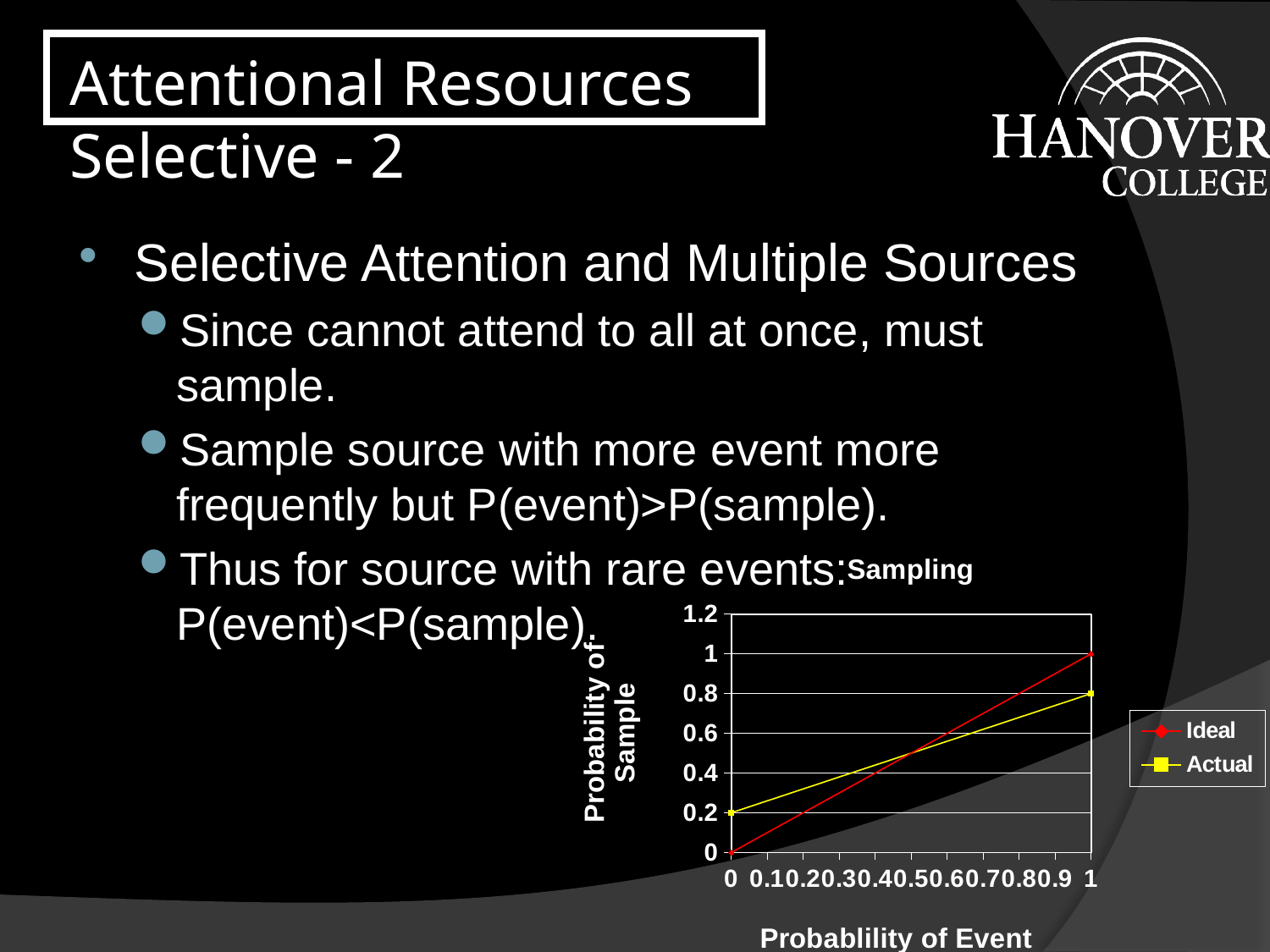
In the "Sampling" chart, what is the difference between the Ideal and Actual Probability of Sample when the Probability of Event is 1? 0.2 What is the title of the chart on the slide? Sampling In the "Sampling" chart, what is the Probability of Sample for the Ideal series when the Probability of Event is 1? 1 In the "Sampling" chart, what is the Probability of Sample for the Ideal series when the Probability of Event is 0? 0 In the "Sampling" chart, what is the Probability of Sample for the Actual series when the Probability of Event is 0? 0.2 In the "Sampling" chart, which series has the higher Probability of Sample when the Probability of Event is 1? Ideal In the "Sampling" chart, what is the Probability of Sample for the Actual series when the Probability of Event is 1? 0.8 What kind of chart is the "Sampling" chart? line chart What are the two series named in the legend of the "Sampling" chart? Ideal and Actual In the "Sampling" chart, which series has the higher Probability of Sample when the Probability of Event is 0? Actual In the "Sampling" chart, does the Actual series rise or fall as the Probability of Event increases? rise How many series does the legend of the "Sampling" chart list? 2